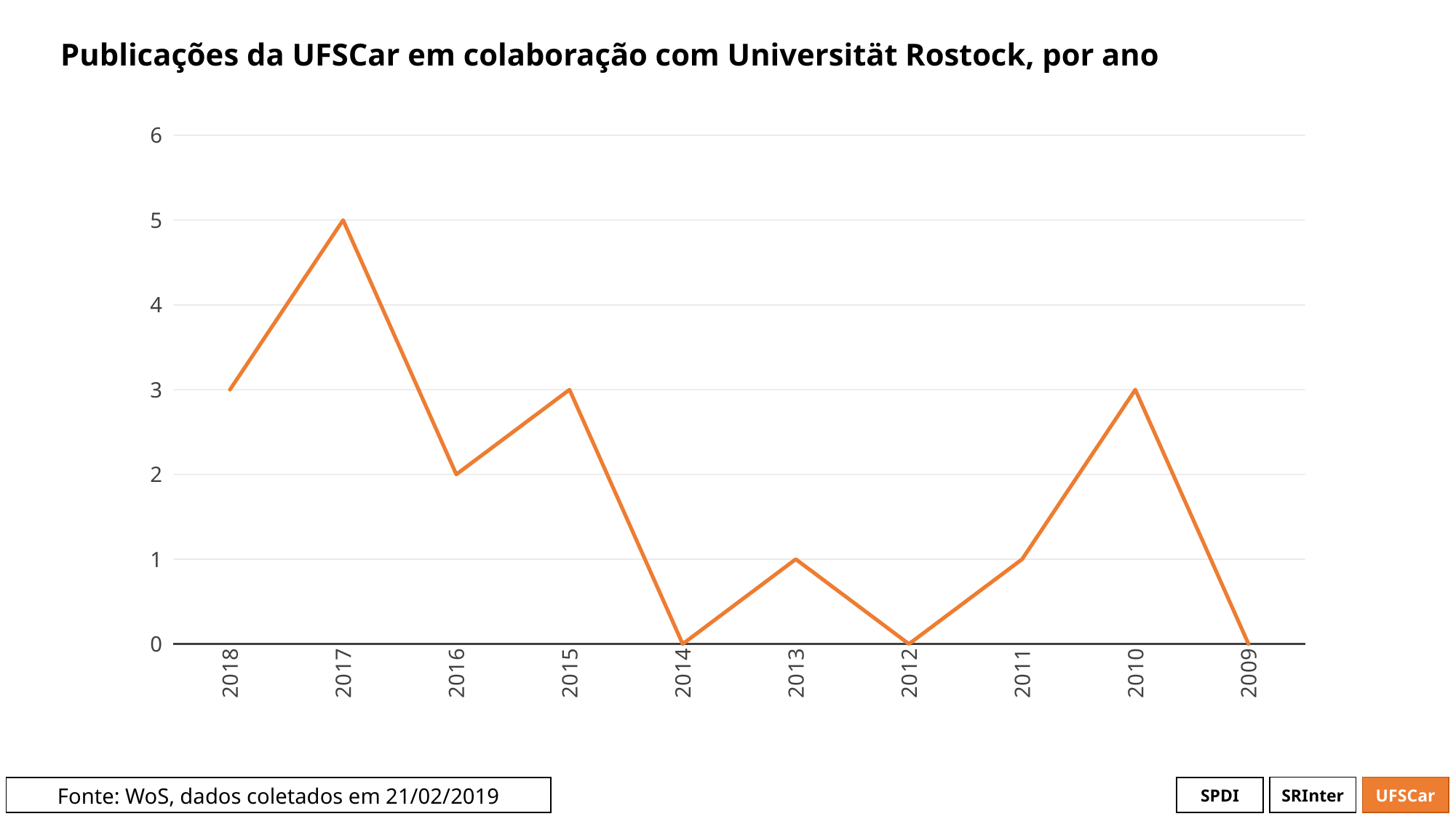
What kind of chart is shown on the slide? line chart What is the title of the chart? Publicações da UFSCar em colaboração com Universität Rostock, por ano Which year has the highest value? 2017 What is the difference between the values for 2017 and 2016? 3 What is the value for 2010? 3 Which is larger, the value for 2015 or the value for 2013? 2015 What is the value for 2017? 5 What is the value for 2018? 3 What is the value for 2016? 2 Which years have a value of 0? 2014, 2012, 2009 Is the value for 2017 greater or less than 4? greater How many years are plotted on the x axis? 10